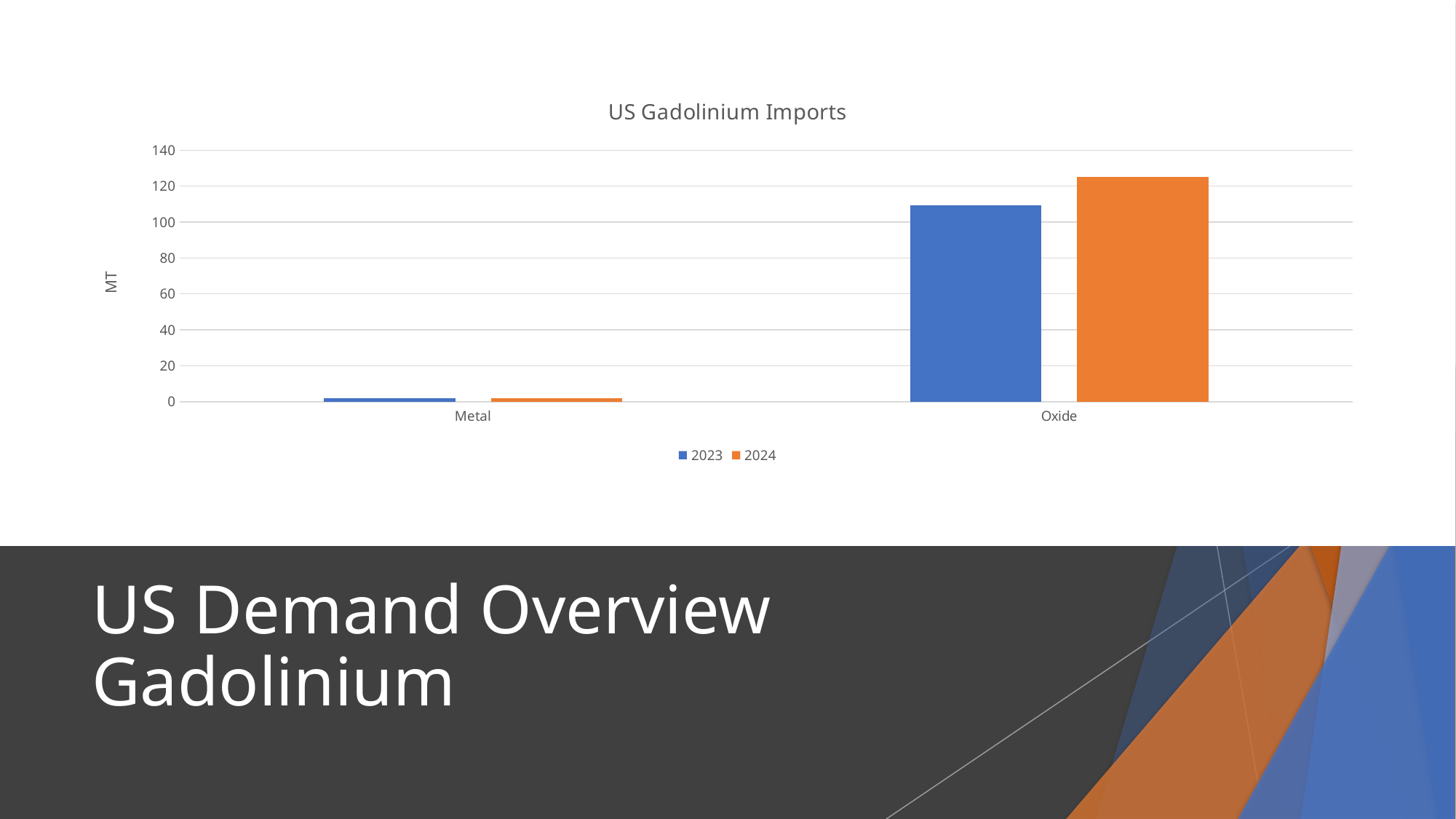
Is the 2023 value for Oxide greater or less than 120? less What is the title of the chart? US Gadolinium Imports How many series does the legend list? 2 Is the 2023 value for Oxide greater or less than 100? greater What is the label on the vertical axis? MT Is the 2024 value for Oxide greater or less than 120? greater What type of chart is shown on the slide? bar chart For Oxide, which year has the larger value, 2023 or 2024? 2024 Which category has the lowest imports? Metal How many categories are shown on the x axis? 2 Which category has the highest imports? Oxide